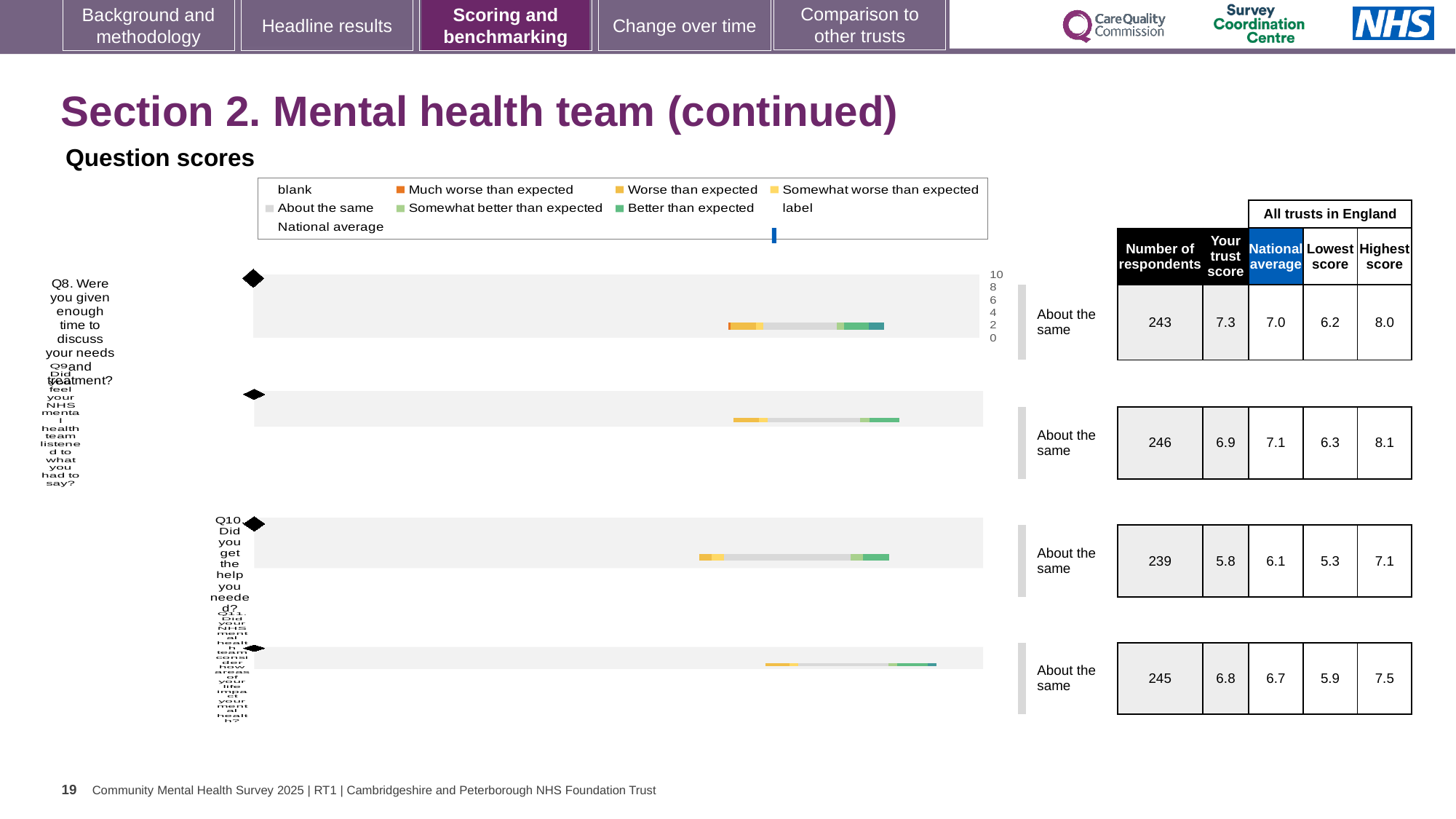
Which question has the lowest trust score on this slide? Q10 What benchmark category is shown for Q10? About the same Which question has the highest number of respondents? Q9 What is the difference between the highest score and the lowest score for Q8? 1.8 What is the national average score for Q9 (Did you feel your NHS mental health team listened to what you had to say?)? 7.1 How many respondents answered Q10 (Did you get the help you needed?)? 239 What is the trust score for Q8 (Were you given enough time to discuss your needs and treatment?)? 7.3 What kind of chart is used for each question score? Bar chart What is the highest score across all trusts in England for Q11? 7.5 What colour represents 'Much worse than expected' in the legend? Orange For Q9, which is larger: the trust score or the national average? National average How many questions are charted on this slide? 4